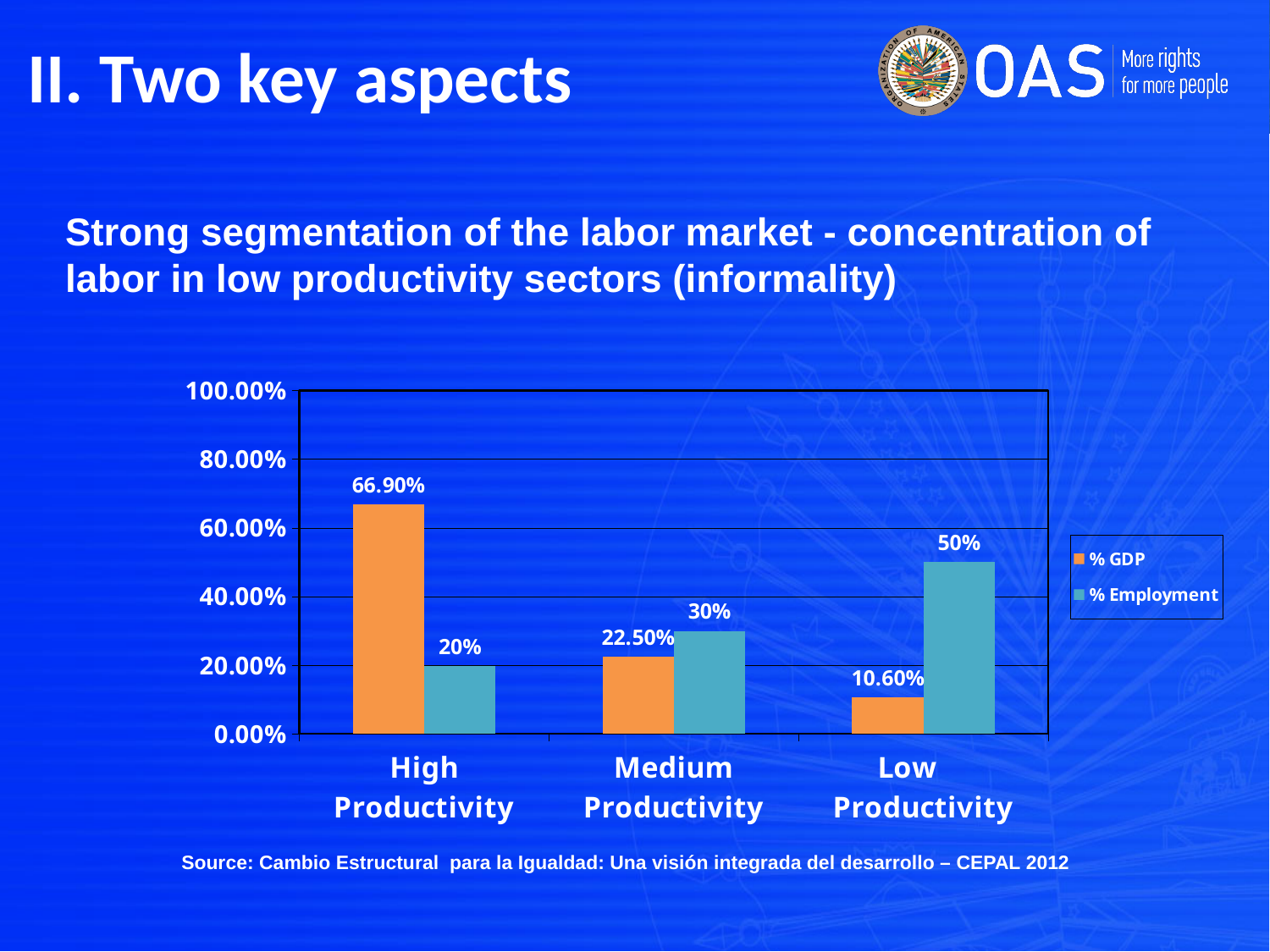
What is the % Employment value for High Productivity? 20% What is the % GDP value for Medium Productivity? 22.50% Which category has the lowest % Employment value? High Productivity What kind of chart is shown on the slide? Bar chart What is the difference between the % GDP and % Employment values for Low Productivity? 39.40% For Medium Productivity, which is larger: % GDP or % Employment? % Employment What is the % GDP value for High Productivity? 66.90% What is the % Employment value for Low Productivity? 50% How many series does the legend list? 2 How many categories are shown on the x axis? 3 Do the % GDP values rise or fall from High Productivity to Low Productivity? Fall Which category has the highest % GDP value? High Productivity